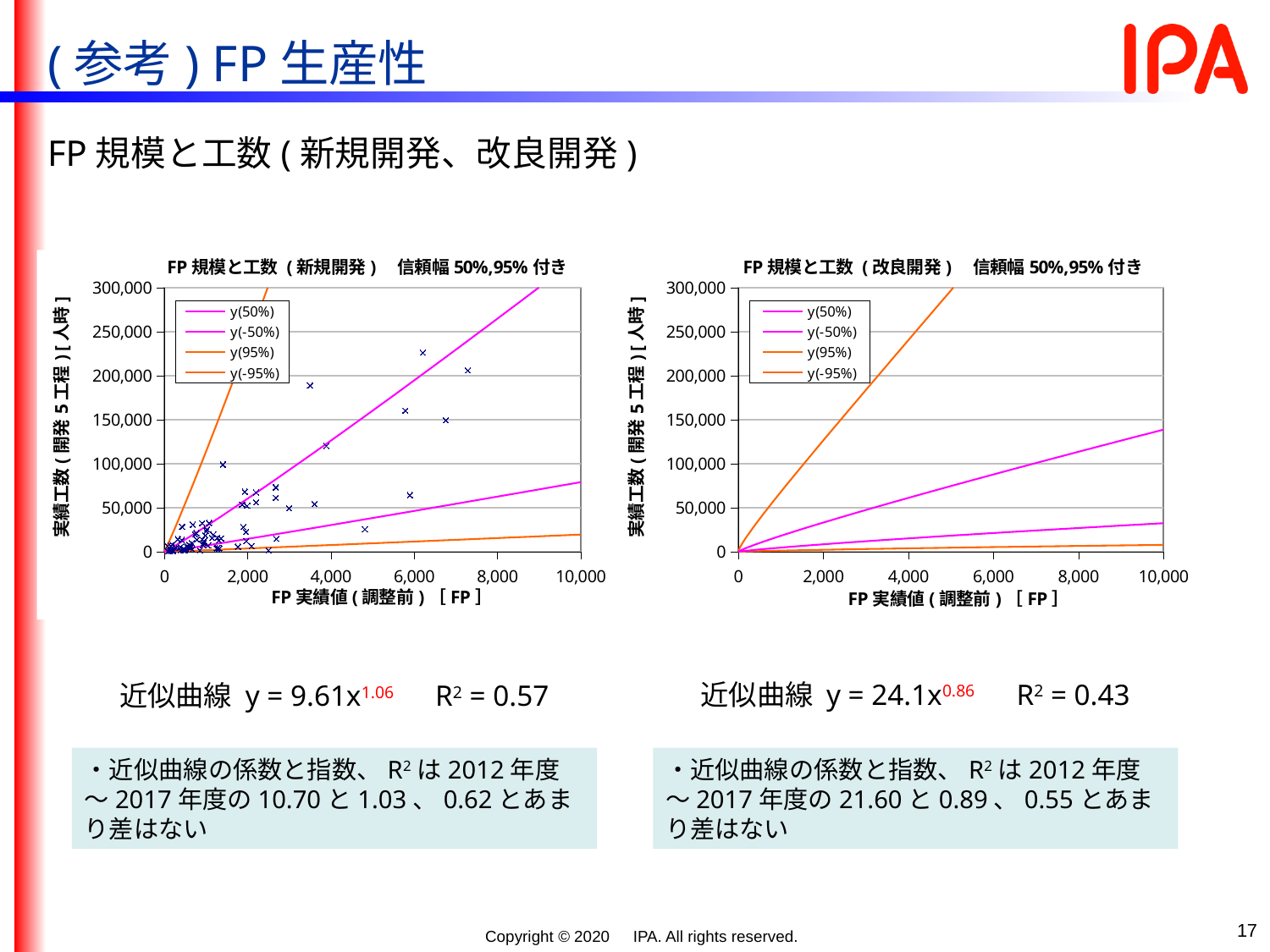
In the right chart (改良開発), is the value of the y(50%) line at 10,000 FP greater or less than 100,000? greater In the left chart (新規開発), how many series does the legend list? 4 In the left chart (新規開発), what kind of chart is it? Scatter chart with fitted lines In the right chart (改良開発), is the value of the y(-50%) line at 10,000 FP greater or less than 50,000? less In the left chart (新規開発), is the value of the y(-50%) line at 10,000 FP greater or less than 50,000? less What is the title of the right chart? FP規模と工数（改良開発） 信頼幅50%,95%付き In the right chart (改良開発), what kind of chart is it? Line chart What is the title of the left chart? FP規模と工数（新規開発） 信頼幅50%,95%付き In the right chart (改良開発), how many series does the legend list? 4 In the right chart (改良開発), does the y(50%) line rise or fall as FP実績値 increases? Rises In the left chart (新規開発), what is the maximum value shown on the vertical axis? 300,000